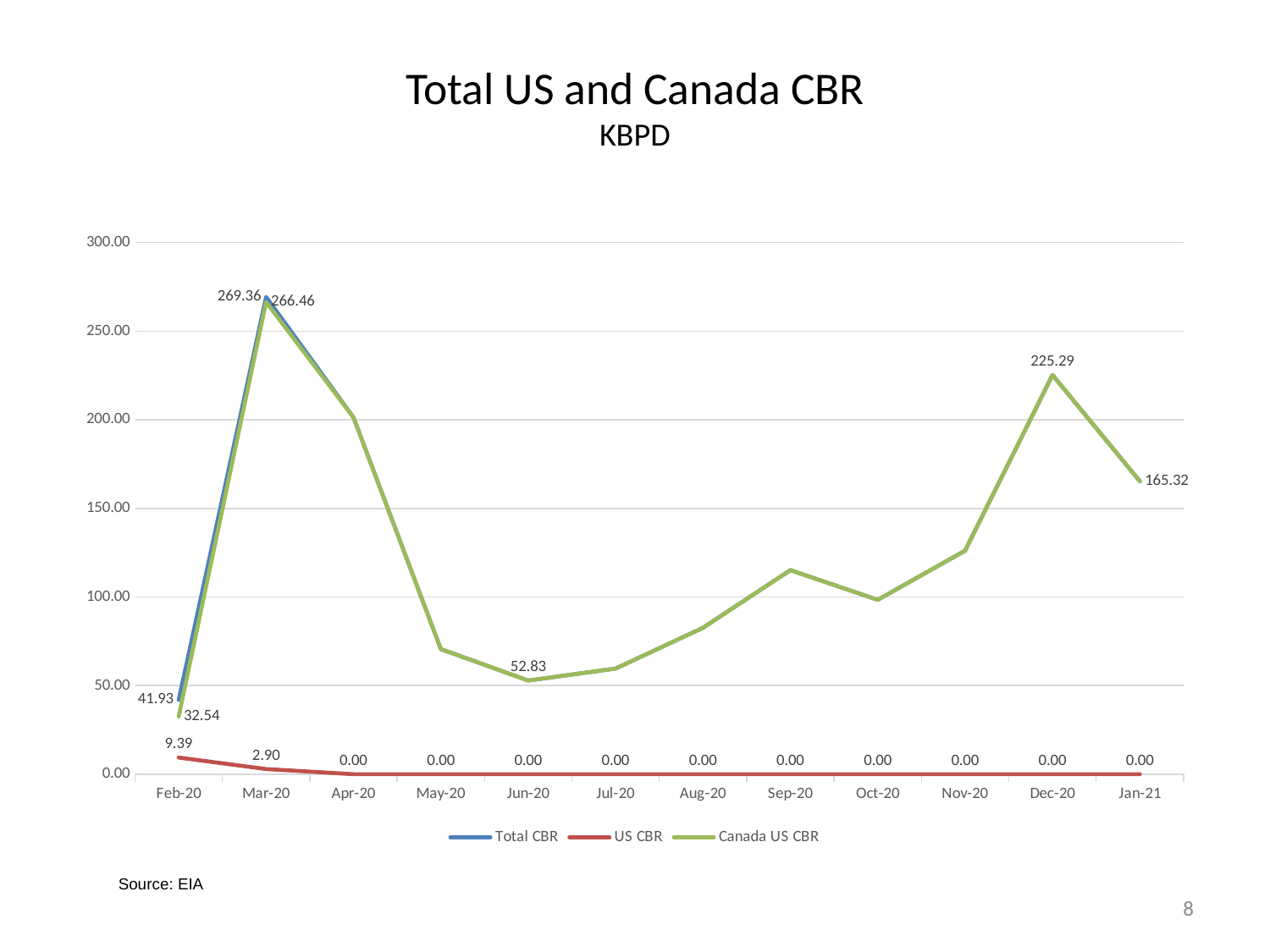
In which month is Total CBR highest? Mar-20 What is the Canada US CBR value for Mar-20? 266.46 How many months are shown on the x axis? 12 How many series does the legend list? 3 What kind of chart is shown on the slide? line chart What is the difference between Total CBR and Canada US CBR in Feb-20? 9.39 Is the Canada US CBR value for Sep-20 greater or less than 100? greater What is the Total CBR value for Mar-20? 269.36 What is the Canada US CBR value for Dec-20? 225.29 What is the US CBR value for Feb-20? 9.39 What is the US CBR value for Jul-20? 0.00 Which is larger, the Canada US CBR value for Dec-20 or for Jan-21? Dec-20